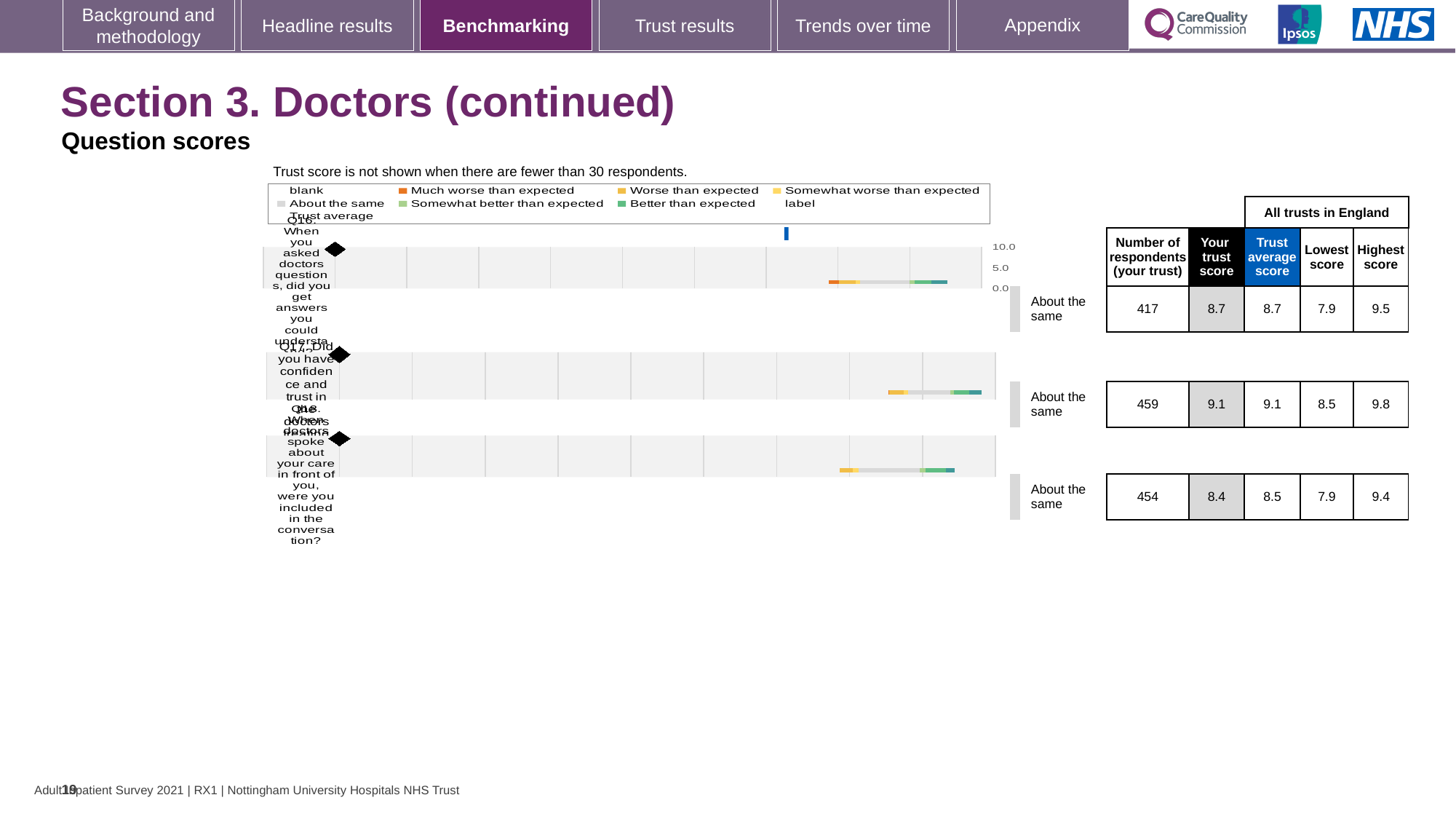
How many questions are plotted in the chart? 3 How many respondents answered Q16 for this trust? 417 What is the trust average score for Q18? 8.5 What benchmark category is shown for Q16? About the same What is the trust score for Q17 (Did you have confidence and trust in the doctors treating you)? 9.1 Which question has the highest trust score? Q17 What is the difference between the trust scores for Q17 and Q18? 0.7 What is the highest score across all trusts in England for Q17? 9.8 Is the trust score for Q17 greater or less than 5.0? greater What kind of chart is used to show the question scores on this slide? bar chart Which question has the lowest trust score? Q18 Which has the higher trust score, Q16 or Q18? Q16